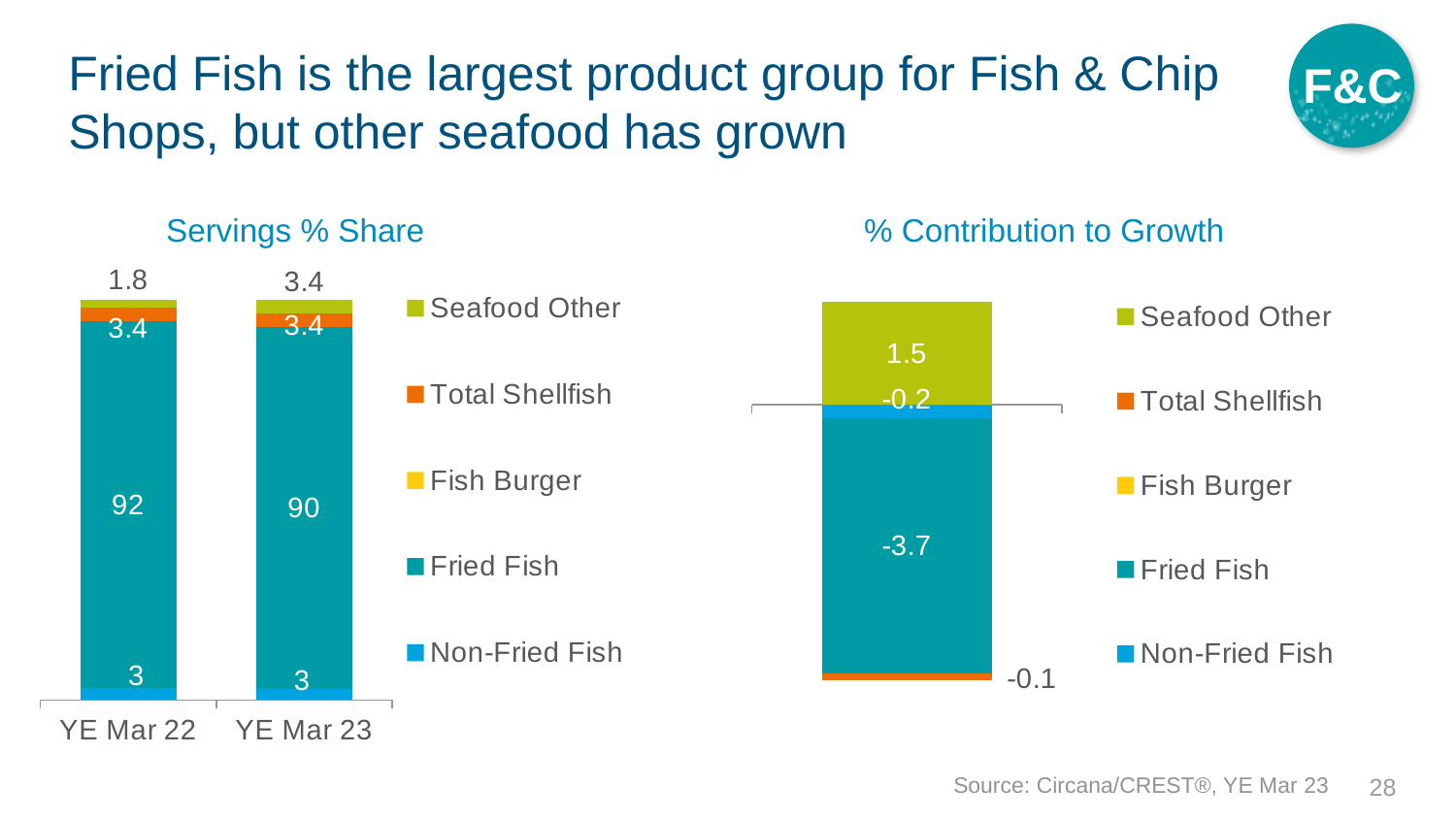
In the Servings % Share chart, what is the value for Seafood Other in YE Mar 22? 1.8 How many series does the legend of the Servings % Share chart list? 5 How many bars (time periods) are shown in the Servings % Share chart? 2 In the Servings % Share chart, what is the value for Fried Fish in YE Mar 23? 90 In the Servings % Share chart, by how much did the Fried Fish share fall from YE Mar 22 to YE Mar 23? 2 In the % Contribution to Growth chart, which product group has the lowest (most negative) contribution? Fried Fish What kind of chart is the Servings % Share chart? Stacked bar chart In the Servings % Share chart, what is the value for Fried Fish in YE Mar 22? 92 In the Servings % Share chart, which year has the larger Fried Fish share, YE Mar 22 or YE Mar 23? YE Mar 22 In the Servings % Share chart, what is the value for Non-Fried Fish in YE Mar 23? 3 In the % Contribution to Growth chart, what is the value for Seafood Other? 1.5 In the % Contribution to Growth chart, what is the value for Fried Fish? -3.7